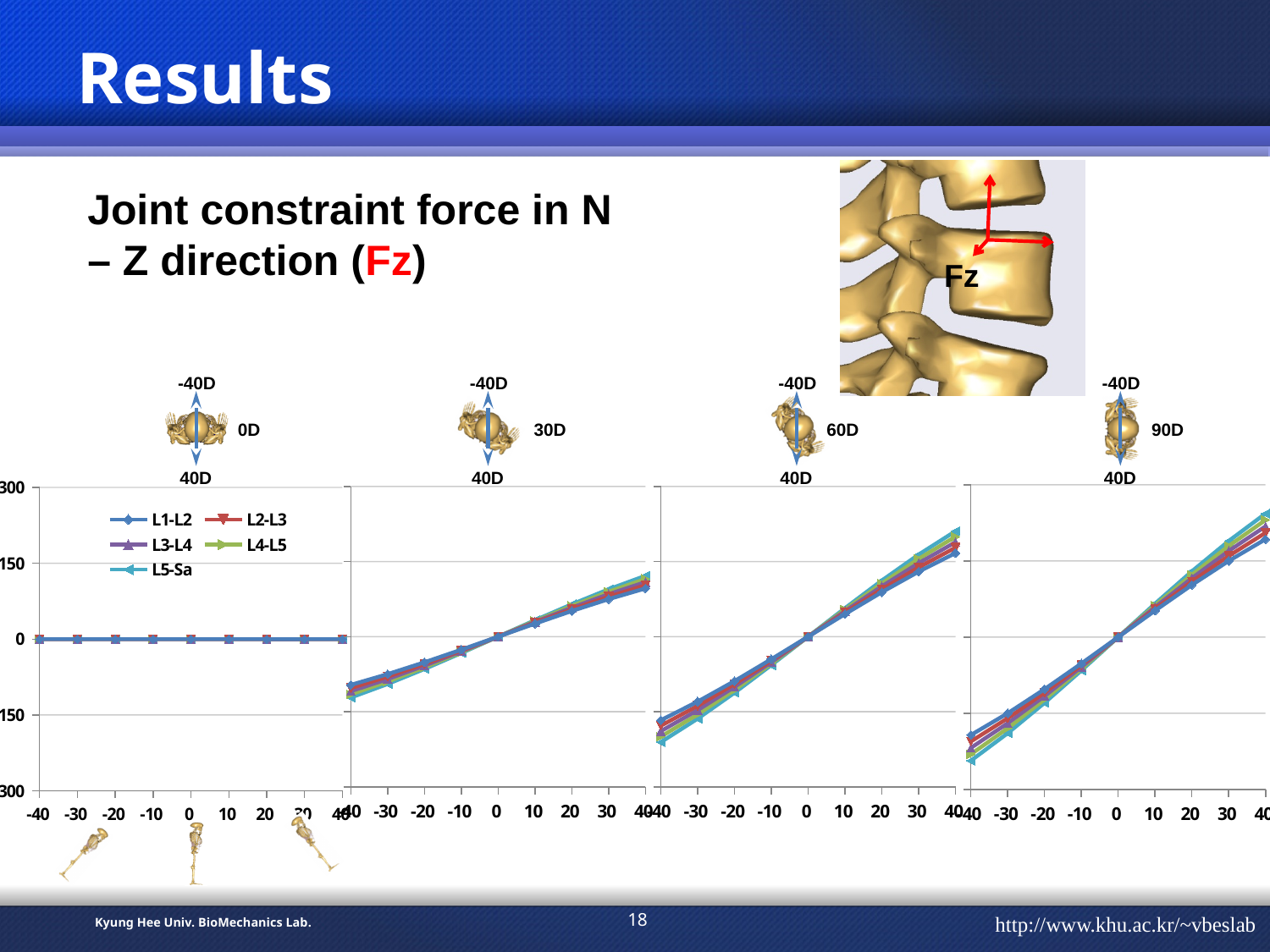
In the 60D chart, is the value for L5-Sa at x = -40 greater or less than -150? less In the 0D chart, is the value for L2-L3 at x = 40 greater or less than 150? less In the 90D chart, which is larger at x = 40: L5-Sa or L1-L2? L5-Sa What kind of chart is used in the 0D panel (leftmost chart)? line chart What quantity do the four charts show, according to the heading above them? Joint constraint force in N – Z direction (Fz) How many series does the legend in the 0D chart list? 5 How many x-axis points are plotted in the 30D chart? 9 Which series is listed last in the legend of the 0D chart? L5-Sa In the 30D chart, do the values rise or fall as x increases from -40 to 40? rise In the 30D chart, is the value for L1-L2 at x = 40 greater or less than 150? less In the 0D chart, what is the value of L1-L2 at x = 0? 0